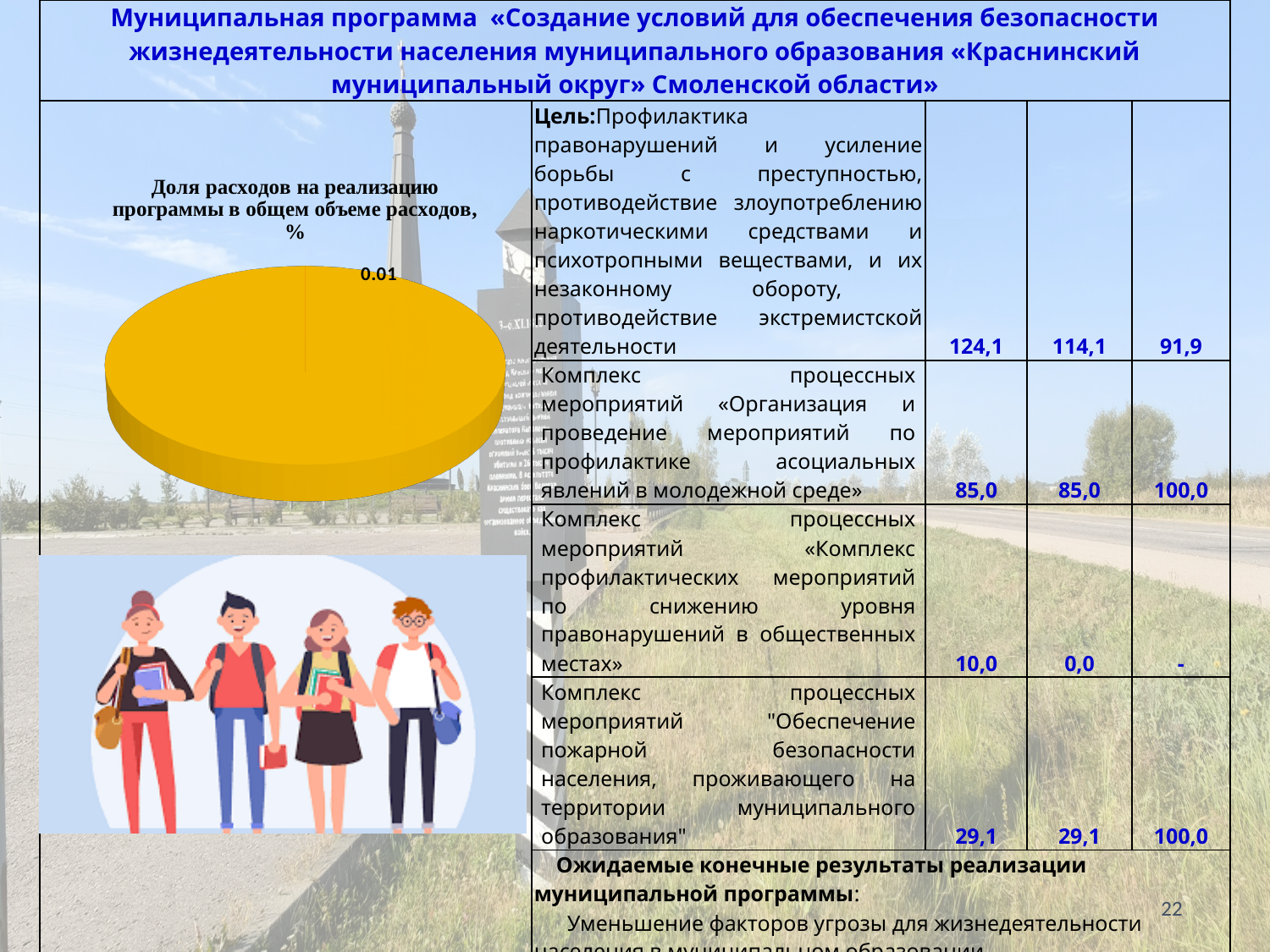
What is the title of the pie chart? Доля расходов на реализацию программы в общем объеме расходов, % What value is printed as the data label on the pie chart? 0.01 What kind of chart is shown on the left of the slide? pie chart What colour is the slice of the pie chart? yellow